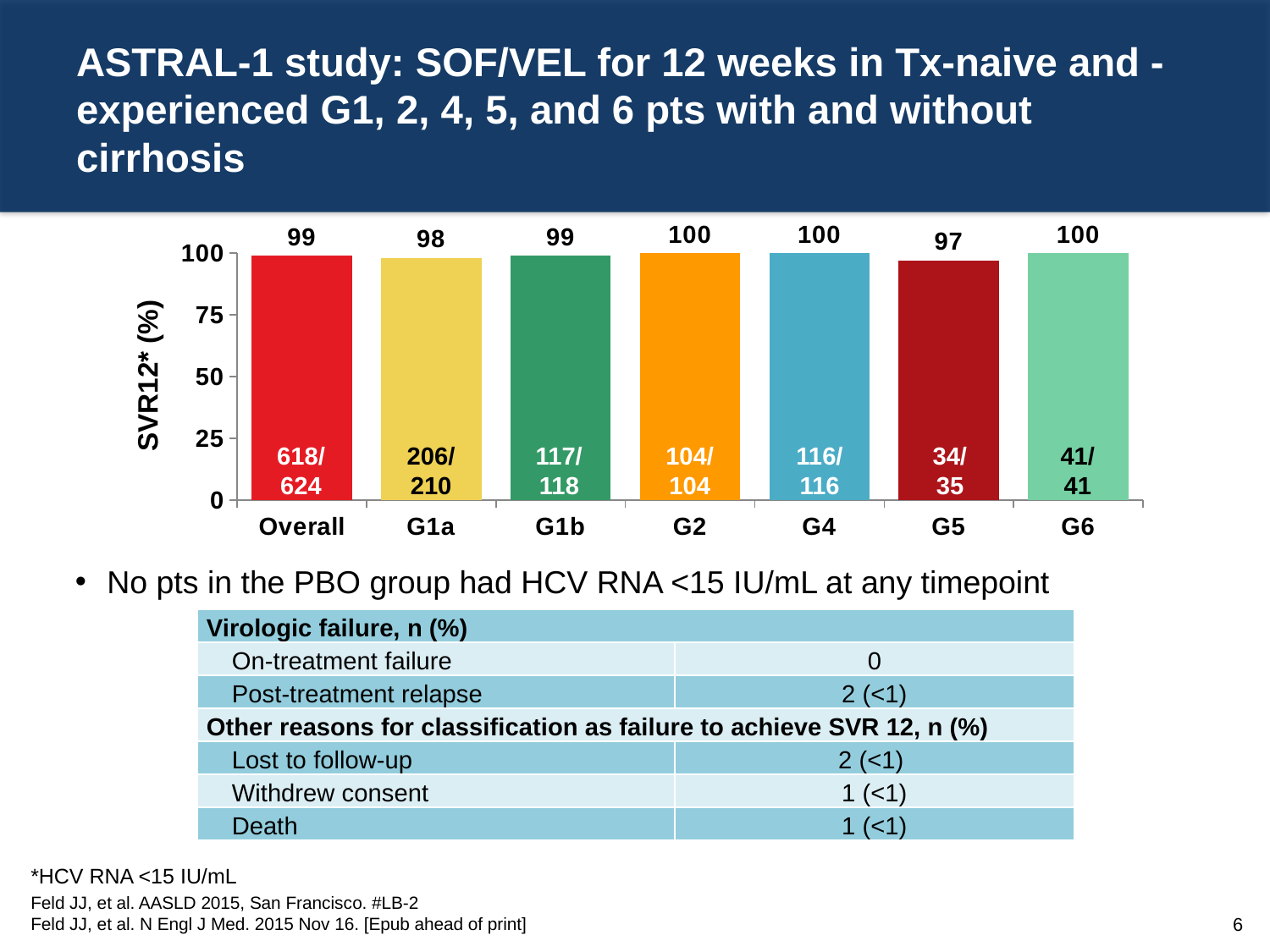
How many bars are shown in the chart? 7 What is the SVR12 value for the Overall group? 99 Is the SVR12 value for G5 greater or less than 75? greater Which is larger, the SVR12 value for G1a or for G1b? G1b What kind of chart is shown on the slide? Bar chart What is the SVR12 value for G5? 97 What fraction (n/N) is printed on the Overall bar? 618/624 What is the difference in SVR12 between G2 and G5? 3 What fraction (n/N) is printed on the G4 bar? 116/116 What is the SVR12 value for G1a? 98 Which genotype group has the lowest SVR12 value? G5 What is the label of the y axis? SVR12* (%)